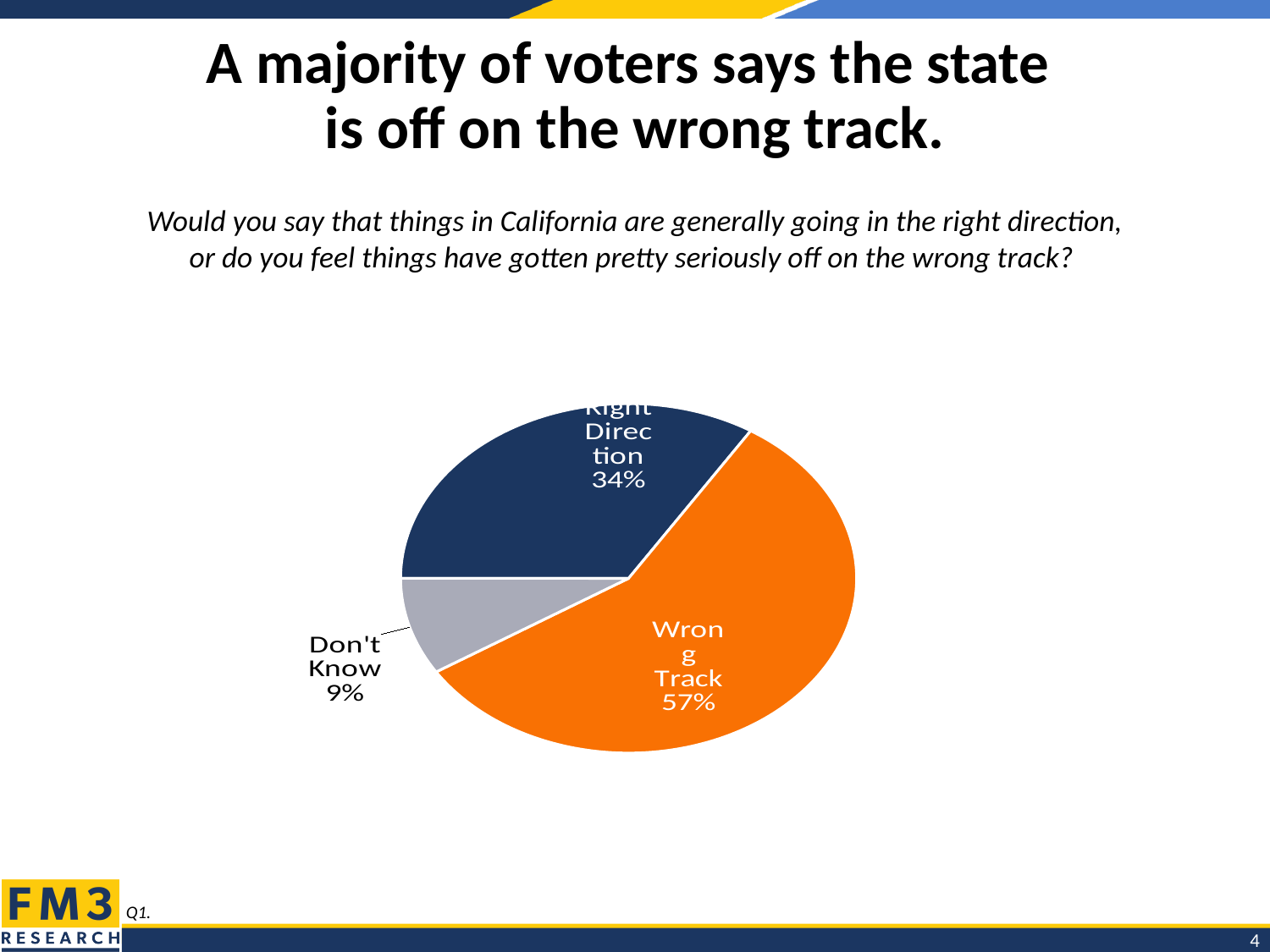
What is the difference in percentage points between Wrong Track and Right Direction? 23 How many slices does the pie chart have? 3 What percentage of voters say the state is on the Wrong Track? 57% What percentage of voters answered Don't Know? 9% What is the combined share of Right Direction and Don't Know? 43% What kind of chart is shown on the slide? Pie chart What percentage of voters say the state is going in the Right Direction? 34% Which is larger, the Right Direction share or the Don't Know share? Right Direction Which response has the smallest share of the pie? Don't Know What colour is the Right Direction slice? Dark blue What colour is the Wrong Track slice? Orange Which response has the largest share of the pie? Wrong Track